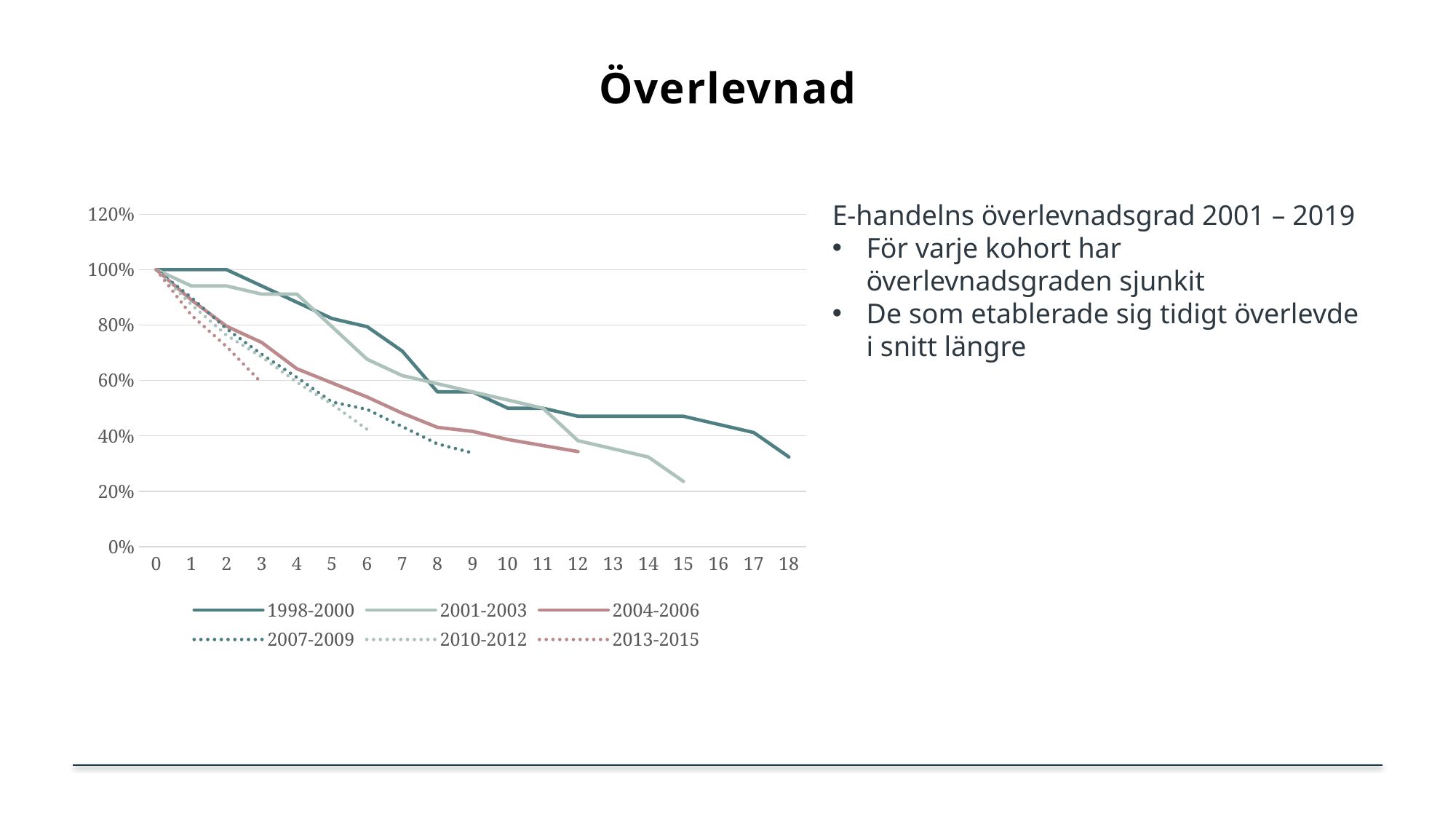
What is the title of the chart slide? Överlevnad Is the value for 1998-2000 at year 4 greater or less than 80%? greater What is the value of the 1998-2000 series at year 0? 100% At year 6, which series has the higher value, 1998-2000 or 2004-2006? 1998-2000 Do the values of the 1998-2000 series rise or fall along the x axis? fall How many series does the legend list? 6 Which series extends furthest along the x axis? 1998-2000 What kind of chart is shown on the slide? line chart Is the value for 1998-2000 at year 18 greater or less than 40%? less At year 12, which series has the higher value, 1998-2000 or 2004-2006? 1998-2000 Is the value for 2004-2006 at year 12 greater or less than 40%? less How many points are labelled on the x axis? 19